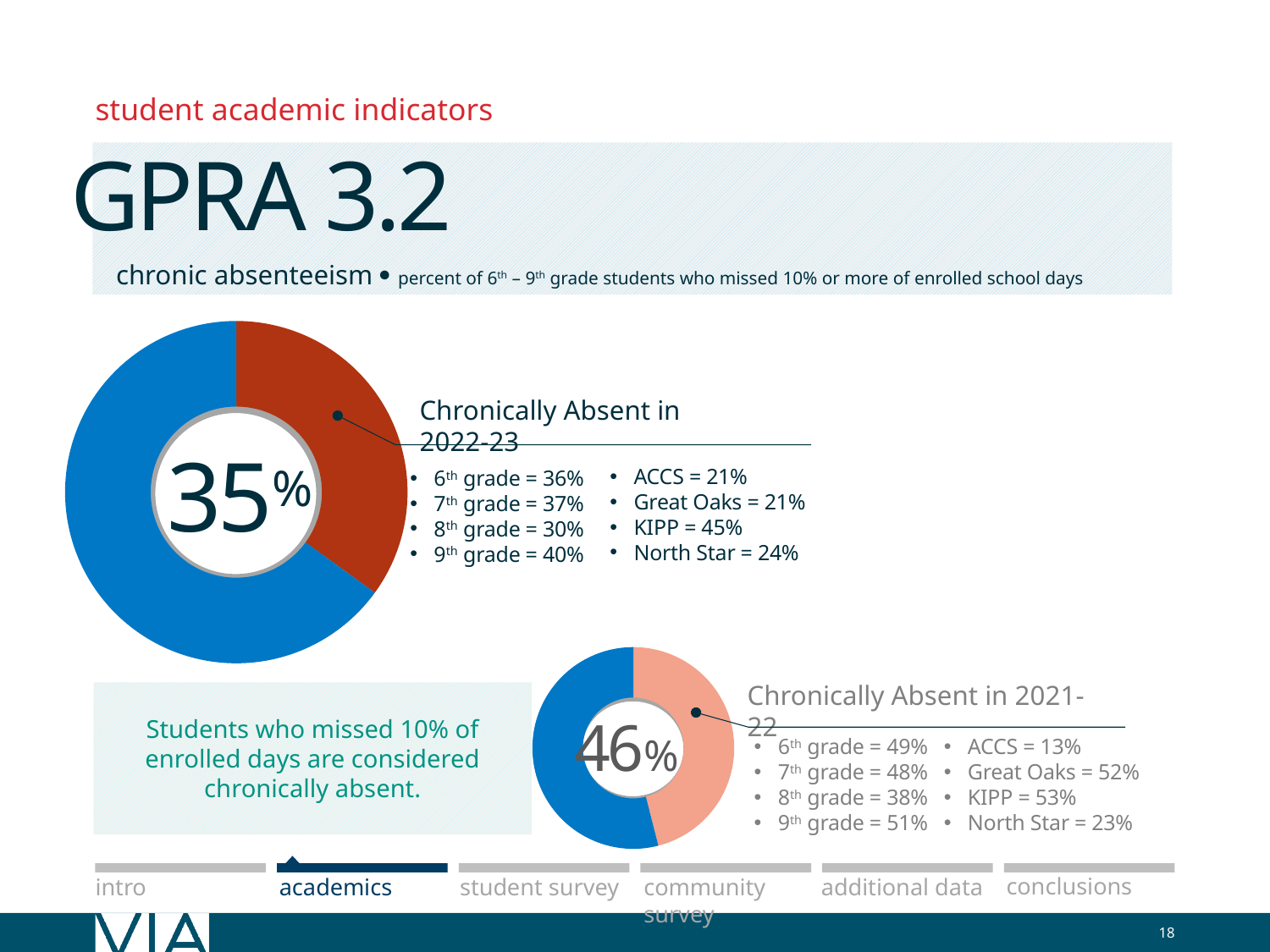
Which year's donut chart shows the higher chronic absenteeism rate, 2022-23 or 2021-22? 2021-22 In the 2021-22 donut chart, what share of the ring does the salmon (chronically absent) slice represent? 46% What colour is the larger, non-absent portion of both donut charts? Blue In the larger donut chart (Chronically Absent in 2022-23), what percentage is shown in the centre? 35% What kind of chart is used to show the chronic absenteeism rates on this slide? Donut (pie) chart What colour is the chronically absent slice in the 2022-23 donut chart? Red Is the chronic absenteeism rate shown in the 2021-22 donut chart greater or less than 50%? less By how many percentage points did the overall chronic absenteeism rate fall from 2021-22 (46%) to 2022-23 (35%)? 11 percentage points Did the overall chronic absenteeism rate rise or fall from 2021-22 to 2022-23 according to the two donut charts? Fall In the 2022-23 donut chart, what share of the ring does the red (chronically absent) slice represent? 35% In the smaller donut chart (Chronically Absent in 2021-22), what percentage is shown in the centre? 46% How many donut charts are shown on the slide? 2